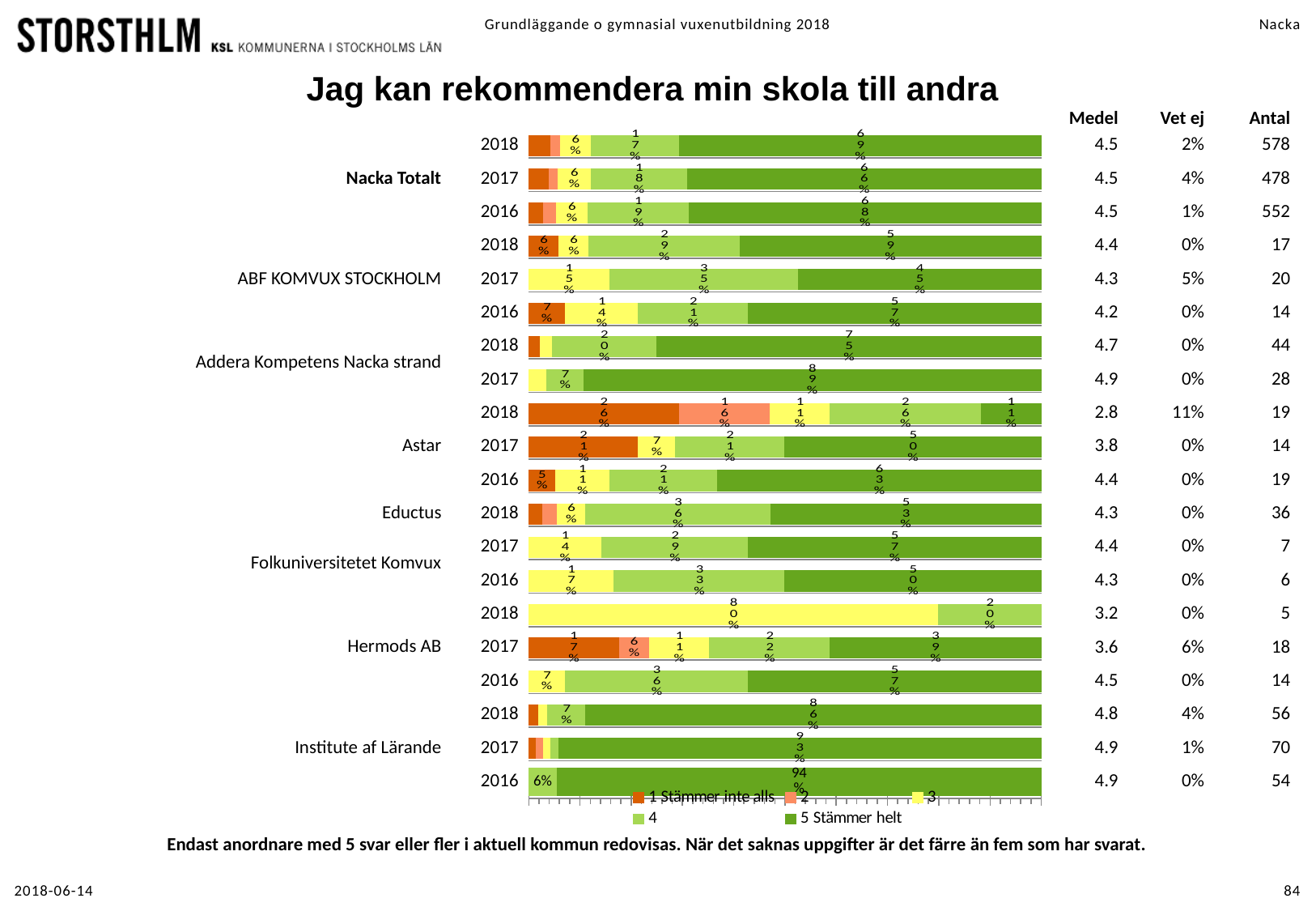
How many series does the chart legend list? 5 What is the value of the '3' segment for Hermods AB in 2018? 80% What is the value of '5 Stämmer helt' for Institute af Lärande in 2016? 94% What is the title of the chart? Jag kan rekommendera min skola till andra What kind of chart is shown on the slide? Stacked bar chart What is the value of '1 Stämmer inte alls' for Astar in 2018? 26% What is the value of '4' for Eductus in 2018? 36% What is the difference in the '5 Stämmer helt' share for Nacka Totalt between 2018 and 2017? 3 percentage points How many bars are plotted in the chart? 20 Which is larger: the '5 Stämmer helt' share for Addera Kompetens Nacka strand in 2017 or in 2018? 2017 What is the value of '5 Stämmer helt' for Nacka Totalt in 2018? 69% Which bar has the highest share of '5 Stämmer helt'? Institute af Lärande 2016